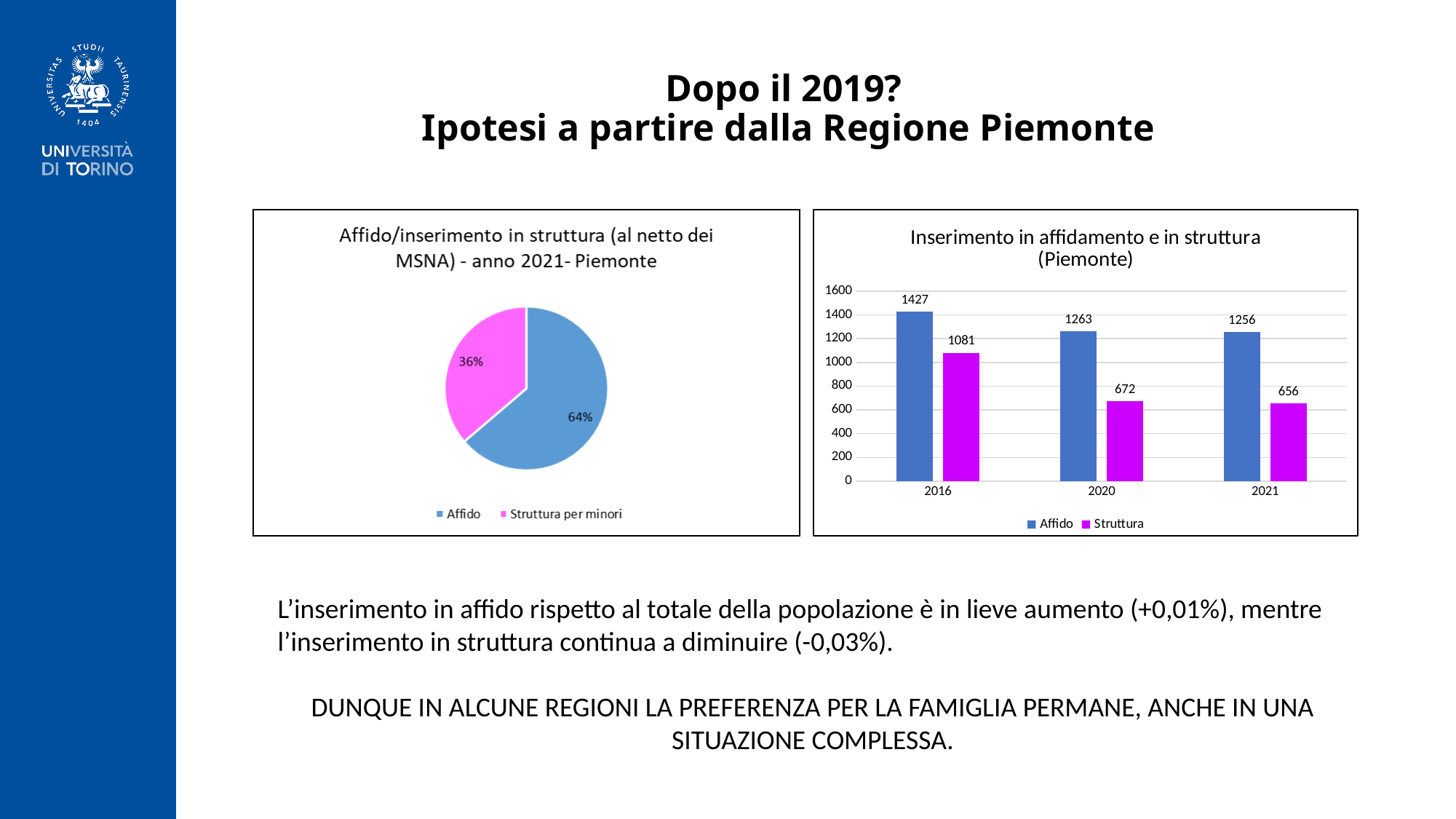
In the bar chart on the right, what is the difference between Affido and Struttura in 2020? 591 In the bar chart on the right, do the Struttura values rise or fall from 2016 to 2021? fall In the bar chart on the right, in which year is the Affido value highest? 2016 What kind of chart is the chart on the left? pie chart In the bar chart on the right, what is the value for Struttura in 2021? 656 In the bar chart on the right, how many years are shown on the x axis? 3 In the bar chart on the right, in which year is the Struttura value lowest? 2021 In the pie chart on the left, which slice is larger, Affido or Struttura per minori? Affido In the bar chart on the right, how many series does the legend list? 2 In the pie chart on the left, what share does Affido have? 64% In the pie chart on the left, what share does Struttura per minori have? 36% In the bar chart on the right, what is the value for Affido in 2016? 1427